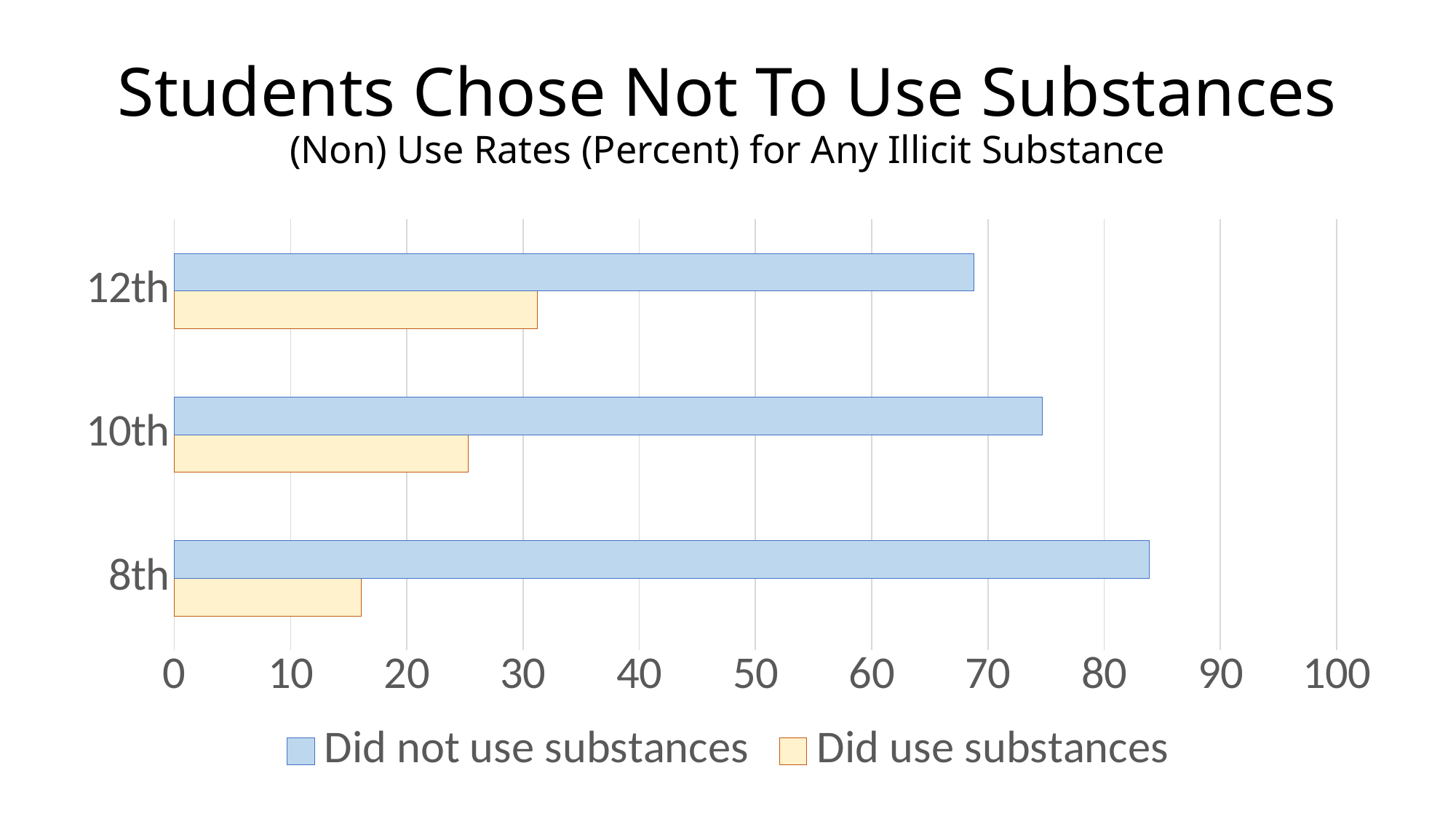
How many grade levels are shown on the chart? 3 Which grade has the lowest value for "Did use substances"? 8th Which grade has the highest value for "Did use substances"? 12th Is the "Did not use substances" value for 10th grade greater or less than 70? greater Which is larger: the "Did not use substances" value for 10th grade or for 12th grade? 10th grade What kind of chart is shown on the slide? Bar chart Is the "Did use substances" value for 12th grade greater or less than 40? less Is the "Did not use substances" value for 8th grade greater or less than 80? greater How many series does the legend list? 2 What colour are the "Did use substances" bars? Light yellow Which grade has the highest value for "Did not use substances"? 8th